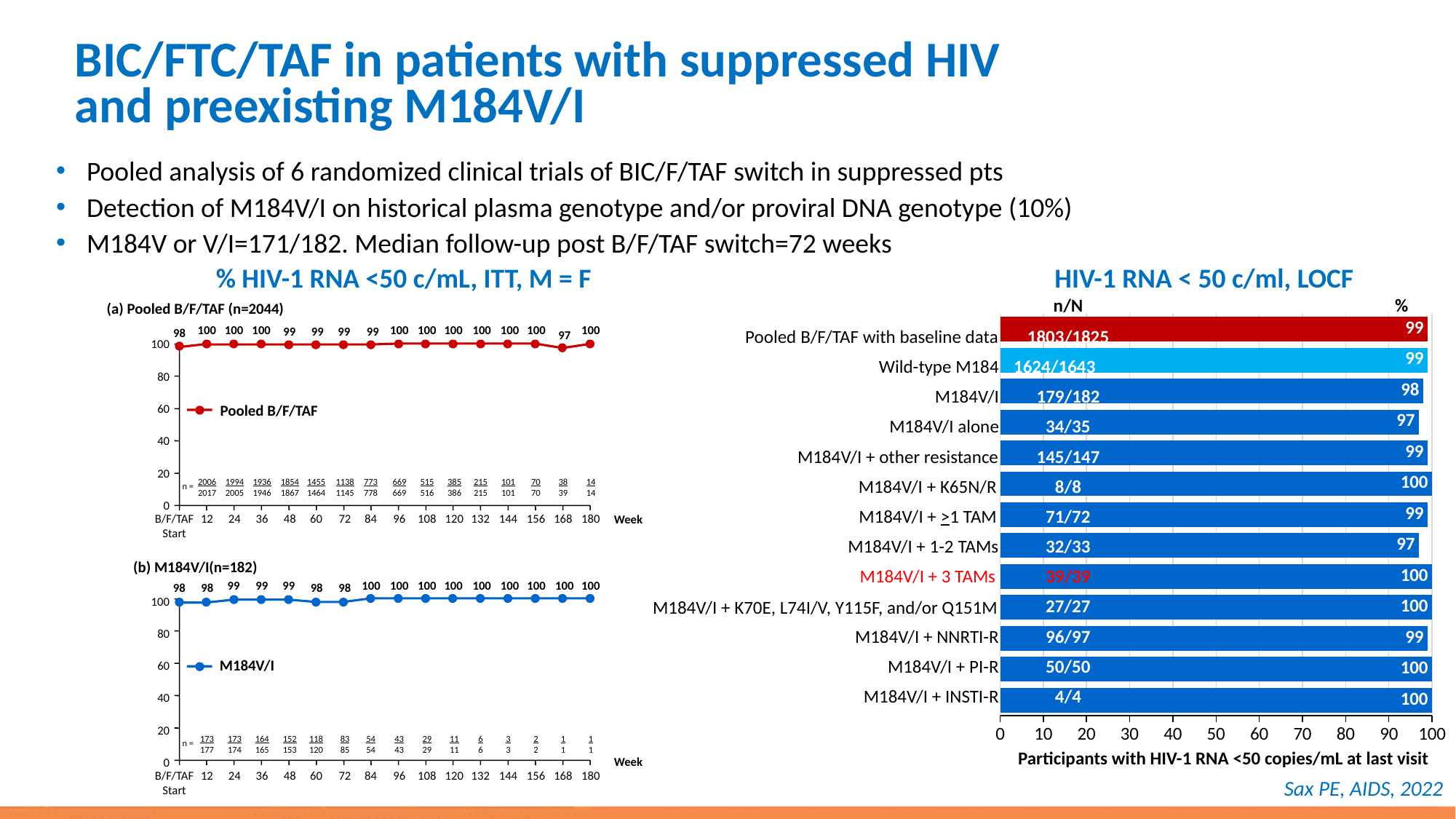
In the line chart '(b) M184V/I (n=182)', does the value rise or fall from week 72 to week 84? rise In the line chart '(a) Pooled B/F/TAF (n=2044)', at which week is the lowest value plotted? 168 In the bar chart titled 'HIV-1 RNA < 50 c/ml, LOCF', what is the difference in percentage between M184V/I + K65N/R and M184V/I alone? 3 In the bar chart titled 'HIV-1 RNA < 50 c/ml, LOCF', what is the x-axis label? Participants with HIV-1 RNA <50 copies/mL at last visit What kind of chart is the chart titled 'HIV-1 RNA < 50 c/ml, LOCF'? bar chart In the bar chart titled 'HIV-1 RNA < 50 c/ml, LOCF', what percentage is shown for M184V/I alone? 97 In the line chart '(a) Pooled B/F/TAF (n=2044)', what is the value at week 168? 97 How many categories are plotted in the bar chart titled 'HIV-1 RNA < 50 c/ml, LOCF'? 13 In the bar chart titled 'HIV-1 RNA < 50 c/ml, LOCF', what is the n/N value for M184V/I + NNRTI-R? 96/97 In the bar chart titled 'HIV-1 RNA < 50 c/ml, LOCF', which has the higher percentage: M184V/I + PI-R or M184V/I + 1-2 TAMs? M184V/I + PI-R In the line chart '(b) M184V/I (n=182)', what is the value at week 60? 98 How many data points are plotted in the line chart '(b) M184V/I (n=182)'? 16